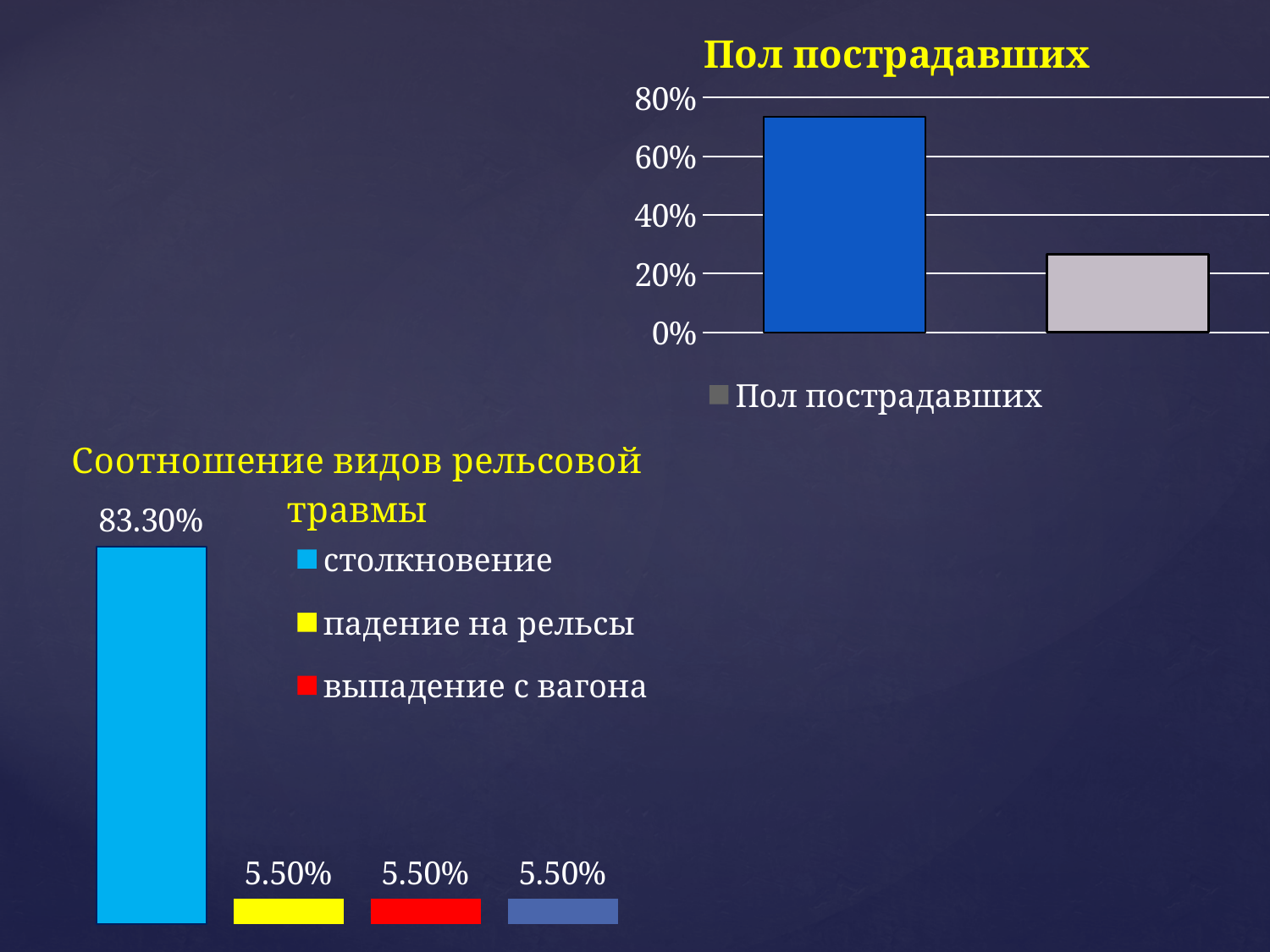
In the chart titled "Соотношение видов рельсовой травмы", what is the difference between the values for столкновение and выпадение с вагона? 77.80% In the chart titled "Соотношение видов рельсовой травмы", what is the value for падение на рельсы? 5.50% In the chart titled "Пол пострадавших", what is the highest value shown on the vertical axis? 80% In the chart titled "Пол пострадавших", is the value of the left (blue) bar greater or less than 60%? greater In the chart titled "Пол пострадавших", how many bars are plotted? 2 In the chart titled "Соотношение видов рельсовой травмы", how many bars are plotted? 4 In the chart titled "Пол пострадавших", is the value of the right (grey) bar greater or less than 40%? less In the chart titled "Соотношение видов рельсовой травмы", which category has the highest value? столкновение In the chart titled "Соотношение видов рельсовой травмы", what is the value for столкновение? 83.30% In the chart titled "Соотношение видов рельсовой травмы", how many entries does the legend list? 3 In the chart titled "Пол пострадавших", which bar is taller, the left blue bar or the right grey bar? the left blue bar In the chart titled "Пол пострадавших", what type of chart is shown? bar chart